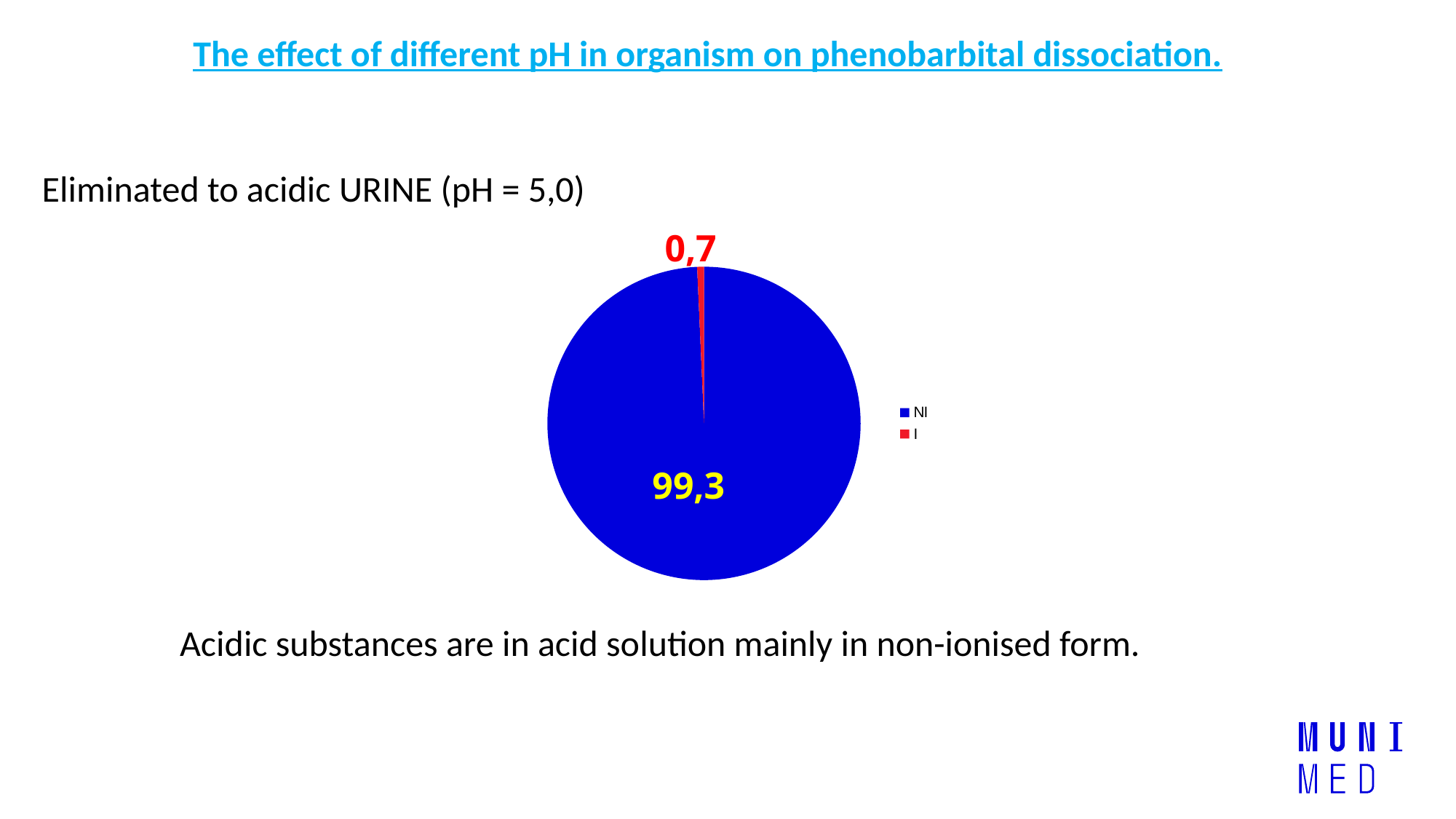
What colour is the NI slice in the pie chart? blue Which category has the largest slice in the pie chart? NI How many slices does the pie chart have? 2 What is the value for NI in the pie chart? 99,3 What colour is the I slice in the pie chart? red Which category has the smallest slice in the pie chart? I What is the difference between the values for NI and I? 98,6 How many entries does the legend list? 2 What kind of chart is shown on the slide? pie chart What is the total of the two values shown in the pie chart? 100 What is the value for I in the pie chart? 0,7 Which is larger, the value for NI or the value for I? NI